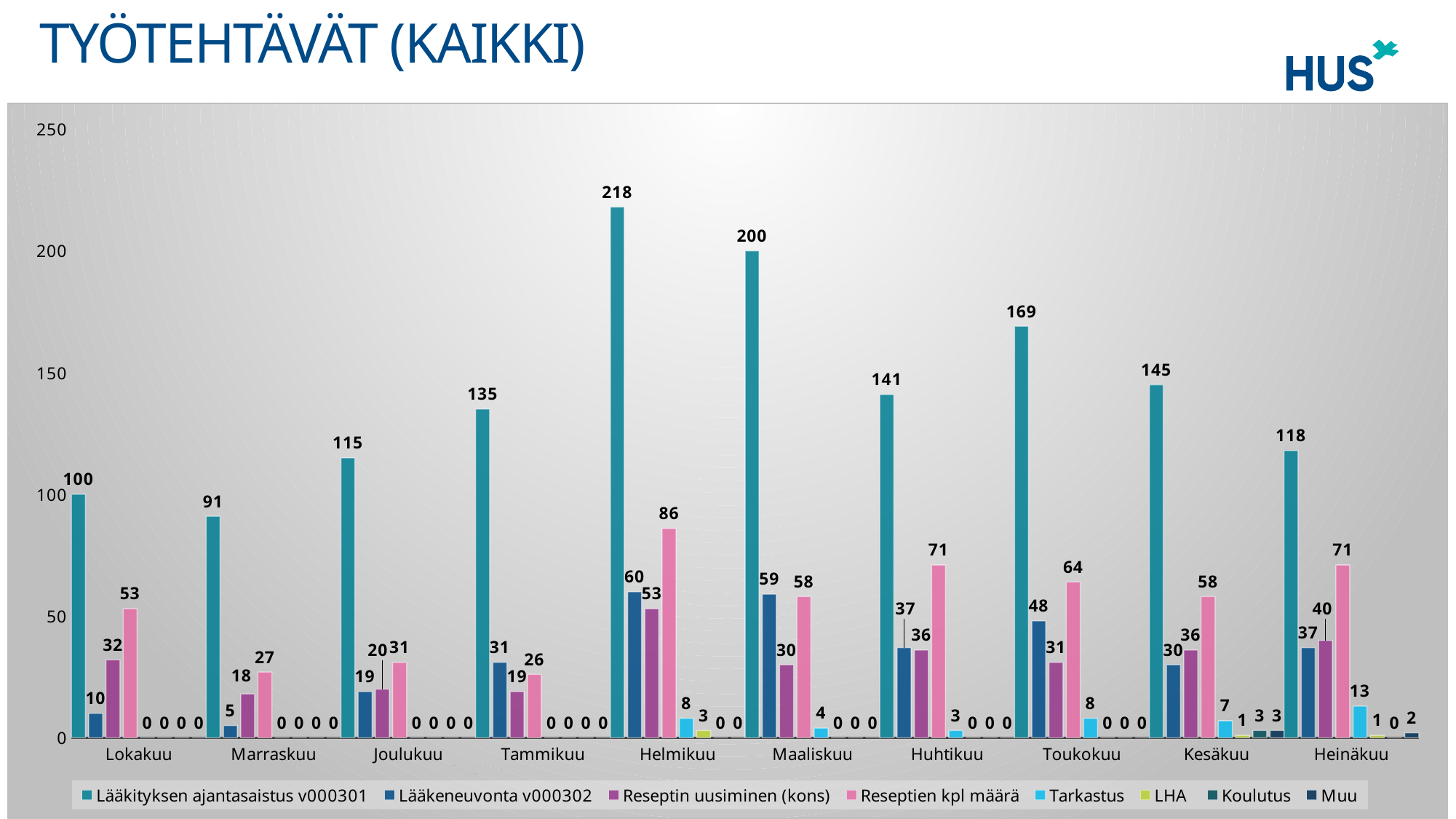
What is the value of Lääkeneuvonta v000302 for Marraskuu? 5 What is the value of Reseptien kpl määrä for Huhtikuu? 71 What is the difference between Lääkityksen ajantasaistus v000301 in Helmikuu and in Maaliskuu? 18 In which month is Lääkityksen ajantasaistus v000301 lowest? Marraskuu How many months are shown on the x axis? 10 What is the value of Lääkityksen ajantasaistus v000301 for Helmikuu? 218 How many series does the legend list? 8 In which month is Lääkityksen ajantasaistus v000301 highest? Helmikuu What is the value of Tarkastus for Heinäkuu? 13 What is the title of the chart? TYÖTEHTÄVÄT (KAIKKI) What kind of chart is shown on the slide? Bar chart Which is larger for Toukokuu: Lääkeneuvonta v000302 or Reseptin uusiminen (kons)? Lääkeneuvonta v000302